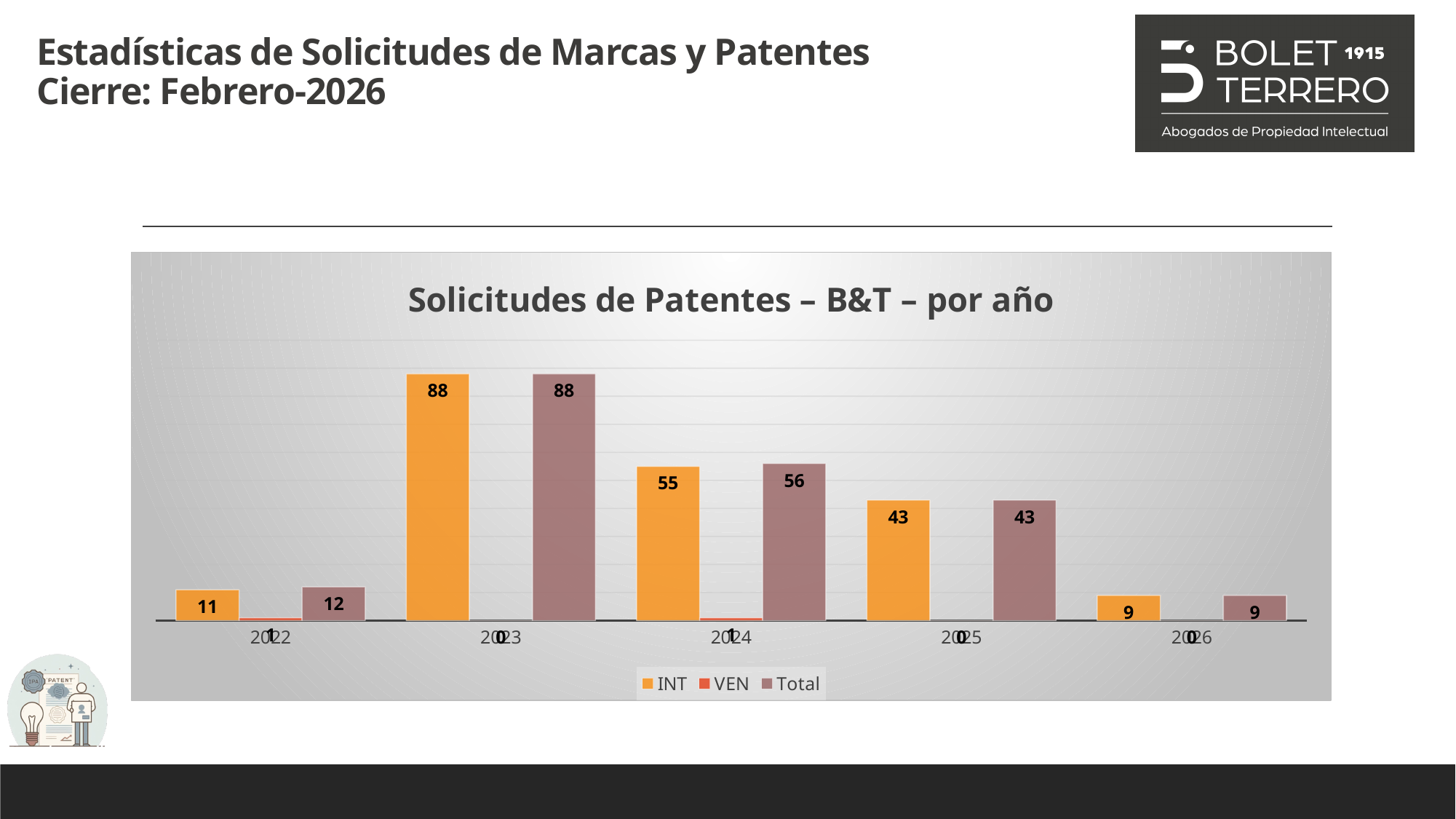
What is the Total value for 2022? 12 What is the INT value for 2026? 9 How many series does the legend list? 3 What kind of chart is shown on the slide? Bar chart How many years are shown on the x axis of the chart? 5 What is the difference between the INT values for 2023 and 2024? 33 Which is larger, the INT value for 2024 or the INT value for 2025? 2024 What is the Total value for 2024? 56 Which year has the highest INT value? 2023 Which year has the lowest Total value? 2026 What is the INT value for 2023 in the chart? 88 Do the Total values rise or fall from 2023 to 2026? Fall